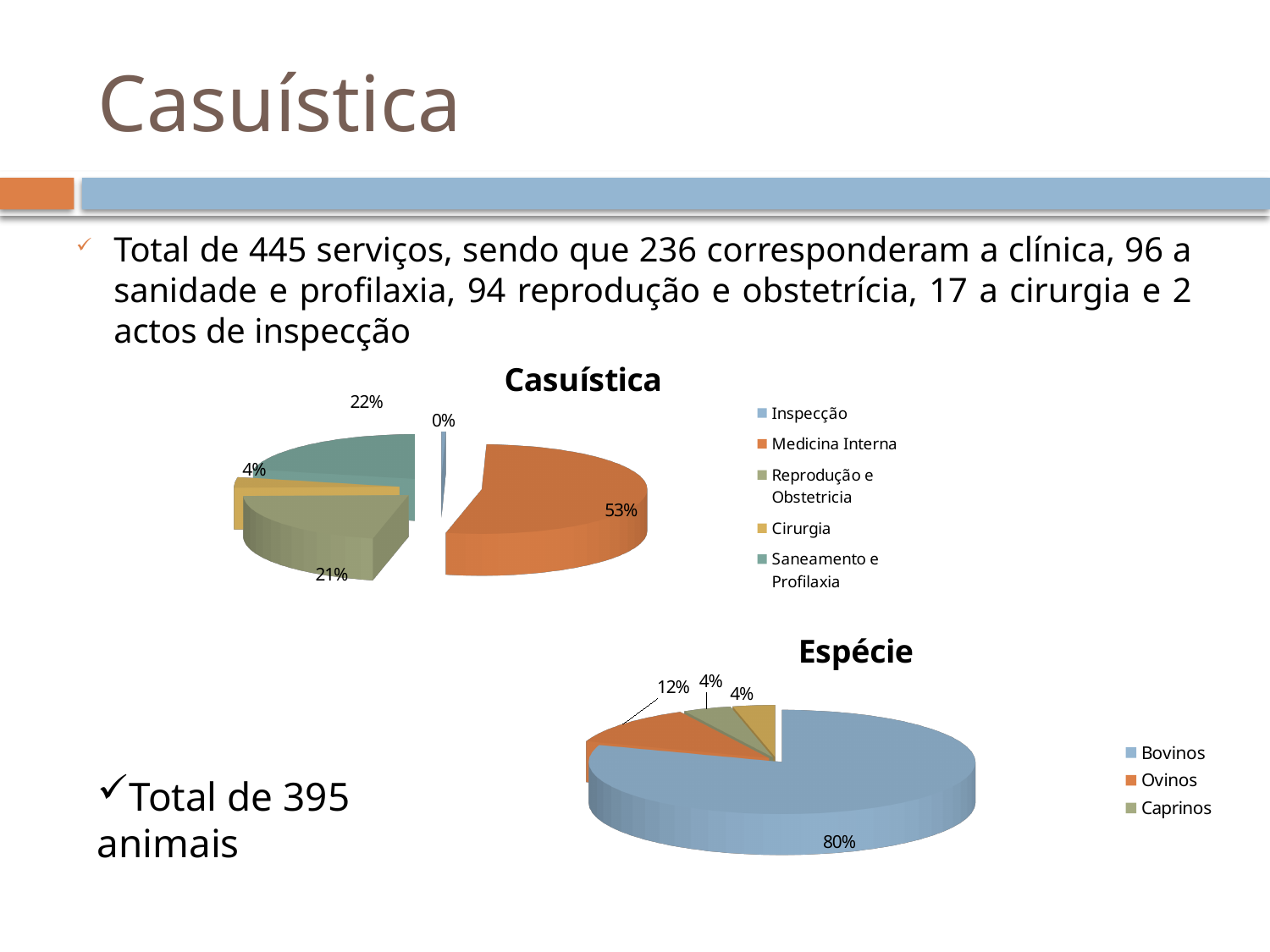
In the Espécie pie chart, what percentage does Bovinos represent? 80% In the Espécie pie chart, which is larger, Ovinos or Caprinos? Ovinos In the Casuística pie chart, what is the difference in percentage points between Medicina Interna and Reprodução e Obstetricia? 32 In the Casuística pie chart, what percentage does Reprodução e Obstetricia represent? 21% In the Casuística pie chart, which category has the largest share? Medicina Interna In the Casuística pie chart, what percentage does Saneamento e Profilaxia represent? 22% In the Casuística pie chart, how many categories does the legend list? 5 In the Casuística pie chart, which category has the smallest share? Inspecção What type of chart is the Espécie chart? Pie chart